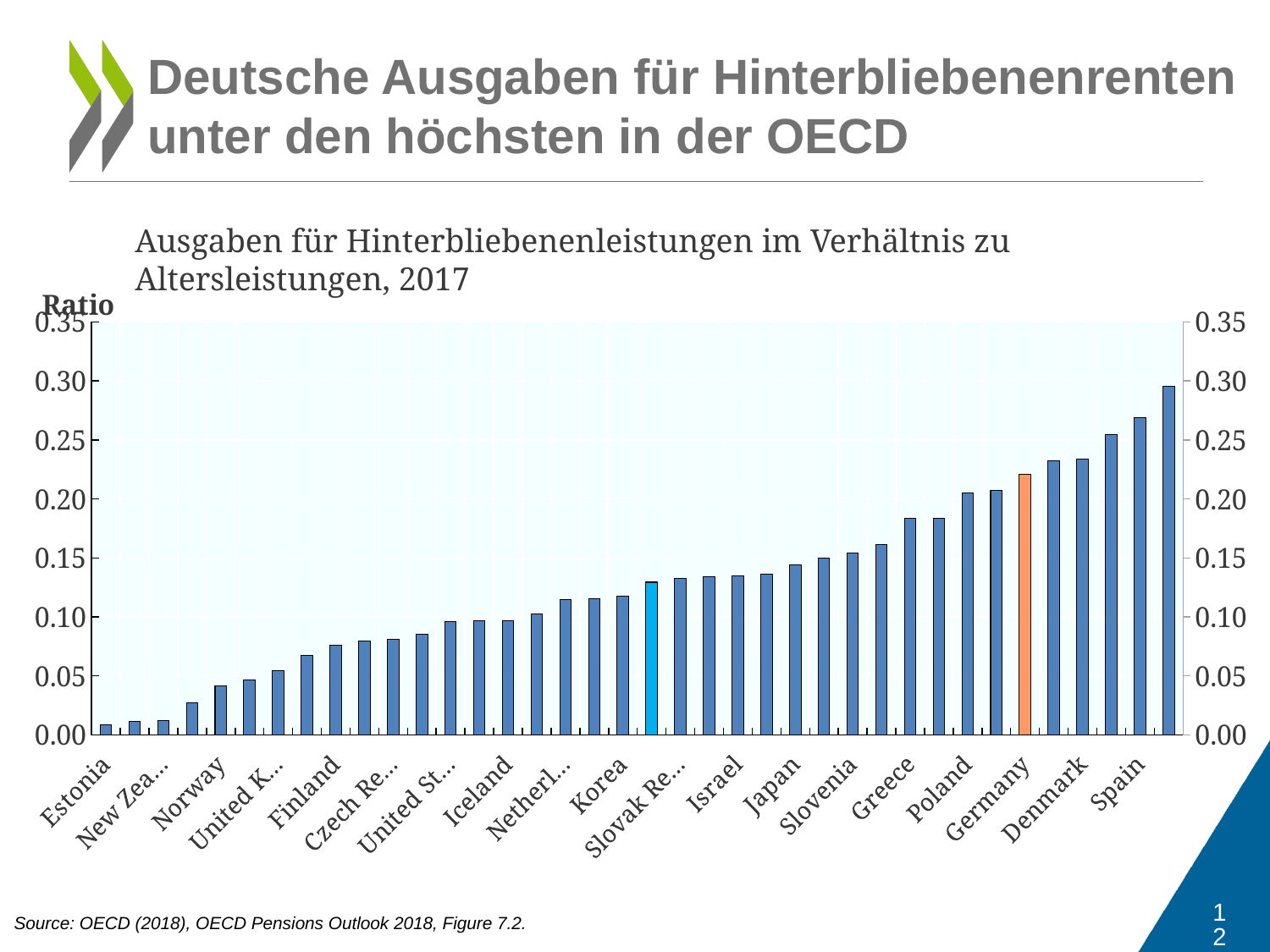
Is the value for Germany greater or less than 0.20? greater Which country has the lowest ratio in the chart? Estonia Is the value for Estonia greater or less than 0.05? less What colour is the bar for Germany? orange Is the value for Greece greater or less than 0.15? greater Which has the larger value, Germany or Spain? Spain Do the values rise or fall moving from left to right along the x axis? rise Which has the larger value, Norway or Finland? Finland What kind of chart is shown on the slide? bar chart